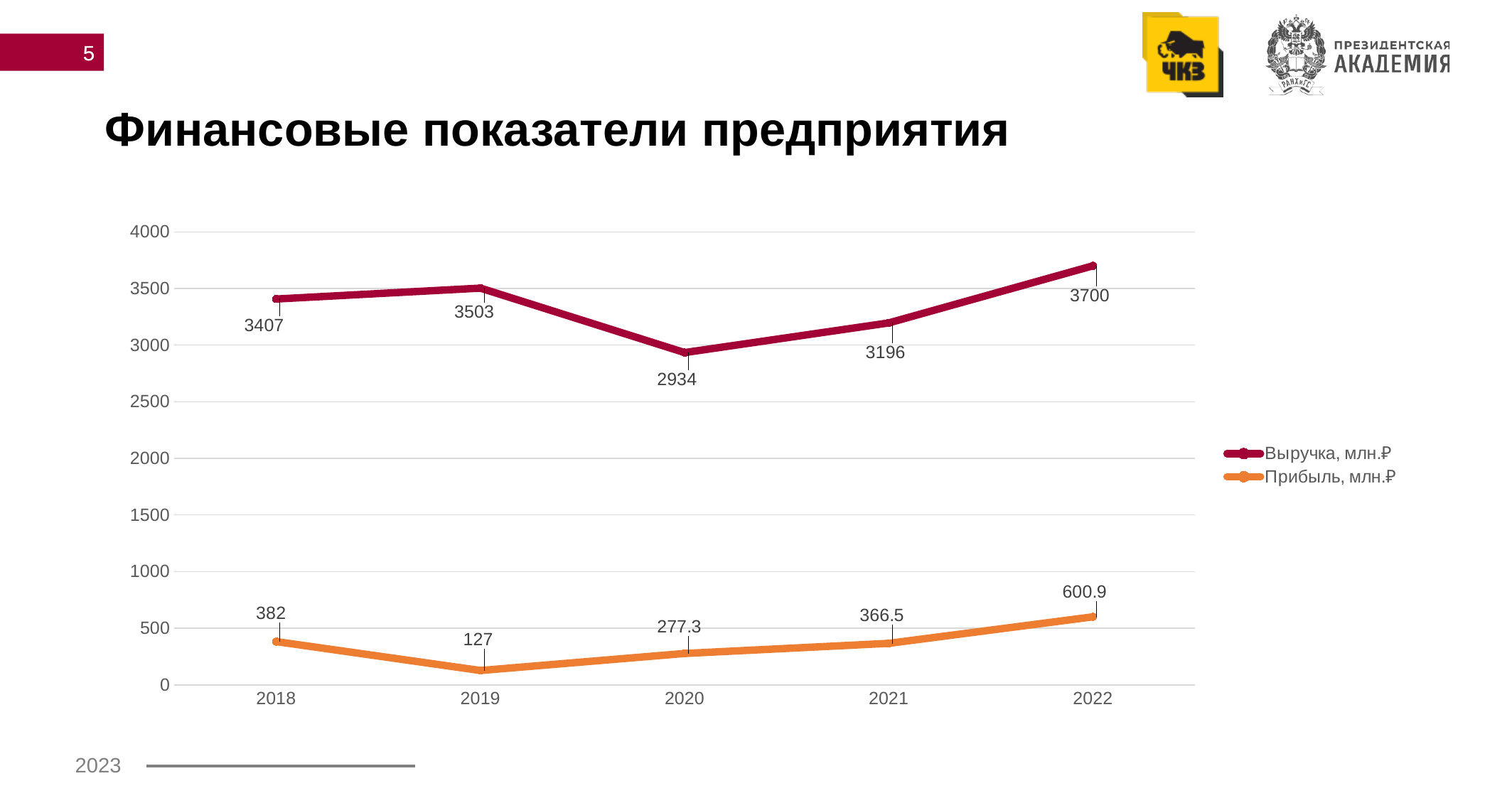
In which year was revenue (Выручка) the highest? 2022 What is the title of the slide? Финансовые показатели предприятия What was the profit (Прибыль, млн.₽) in 2022? 600.9 What was the revenue (Выручка, млн.₽) in 2020? 2934 Did profit (Прибыль) rise or fall from 2019 to 2022? rise How many series does the legend list? 2 Which year had higher profit (Прибыль): 2018 or 2021? 2018 Is the revenue value for 2019 greater or less than 3500? greater What kind of chart is shown on the slide? line chart What is the difference between revenue in 2022 and revenue in 2021? 504 How many years are shown on the x axis? 5 In which year was profit (Прибыль) the lowest? 2019